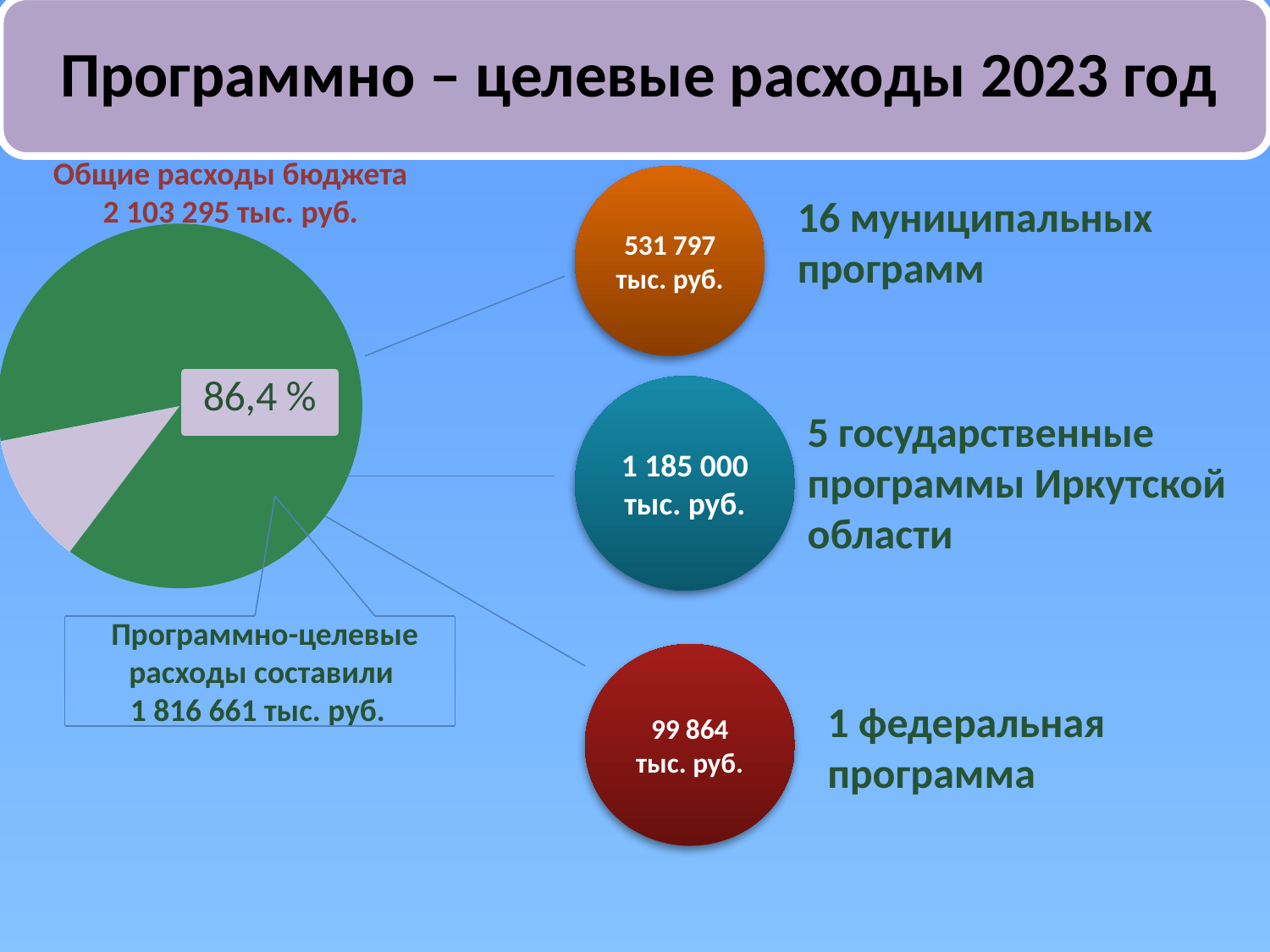
How many slices does the pie chart have? 2 According to the slide, what were the programme-targeted expenses (Программно-целевые расходы)? 1 816 661 тыс. руб. What value is shown in the circle for the 1 federal programme? 99 864 тыс. руб. Which of the three programme groups has the largest amount? 5 государственные программы Иркутской области Which of the three programme groups has the smallest amount? 1 федеральная программа What value is shown in the circle for the 5 state programmes of Irkutsk Oblast? 1 185 000 тыс. руб. What is the difference between the amount for the state programmes of Irkutsk Oblast and the amount for the municipal programmes? 653 203 тыс. руб. What kind of chart is shown on the left of the slide? pie chart Which slice of the pie chart is larger, the green one or the light purple one? green What are the total budget expenses (Общие расходы бюджета) shown above the pie chart? 2 103 295 тыс. руб. What share of the pie chart is labelled on the green slice? 86,4 % What value is shown in the circle for the 16 municipal programmes? 531 797 тыс. руб.